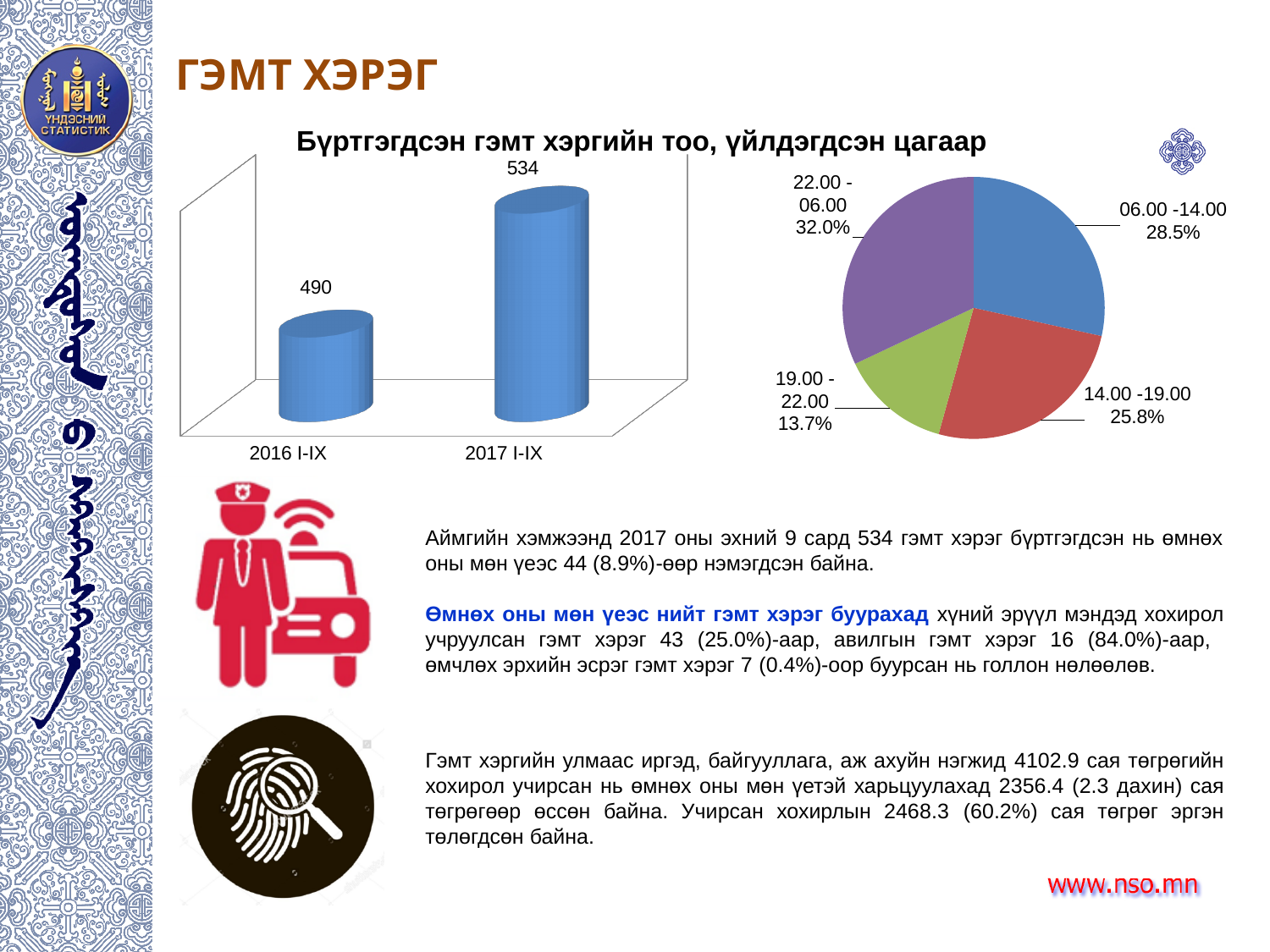
On the pie chart on the right, which is larger: the share for 06.00 - 14.00 or for 14.00 - 19.00? 06.00 - 14.00 On the bar chart on the left, which category has the higher value? 2017 I-IX On the bar chart on the left, how many categories are shown? 2 On the pie chart on the right, how many slices are there? 4 On the pie chart on the right, what share does the 19.00 - 22.00 slice have? 13.7% On the bar chart on the left, what is the value for 2016 I-IX? 490 On the pie chart on the right, what share does the 22.00 - 06.00 slice have? 32.0% On the pie chart on the right, which time period has the largest share? 22.00 - 06.00 On the pie chart on the right, which time period has the smallest share? 19.00 - 22.00 What kind of chart is the chart on the left of the slide? bar chart On the bar chart on the left, what is the value for 2017 I-IX? 534 On the bar chart on the left, what is the difference between the 2017 I-IX and 2016 I-IX values? 44